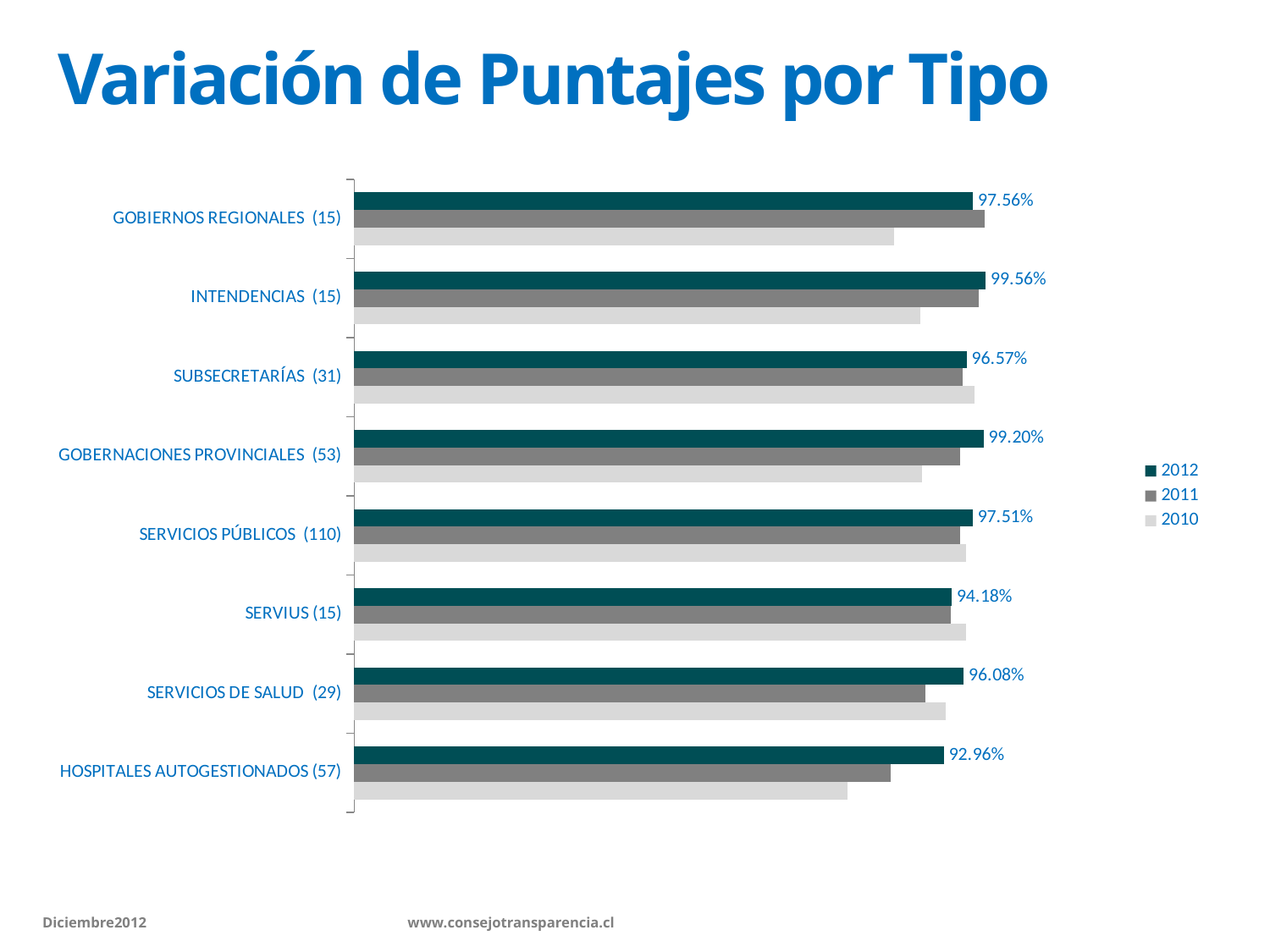
What kind of chart is shown on the slide? Bar chart What is the 2012 value for SERVICIOS PÚBLICOS (110)? 97.51% What is the 2012 value for SERVIUS (15)? 94.18% Which has the larger 2012 value, SERVIUS (15) or SERVICIOS DE SALUD (29)? SERVICIOS DE SALUD (29) What is the difference between the 2012 values for INTENDENCIAS (15) and HOSPITALES AUTOGESTIONADOS (57)? 6.60 percentage points Which category has the lowest 2012 value? HOSPITALES AUTOGESTIONADOS (57) What is the 2012 value for HOSPITALES AUTOGESTIONADOS (57)? 92.96% For HOSPITALES AUTOGESTIONADOS (57), which bar is longer, 2012 or 2010? 2012 What is the 2012 value for INTENDENCIAS (15)? 99.56% Which category has the highest 2012 value? INTENDENCIAS (15) How many categories are shown on the chart? 8 How many series does the legend list? 3